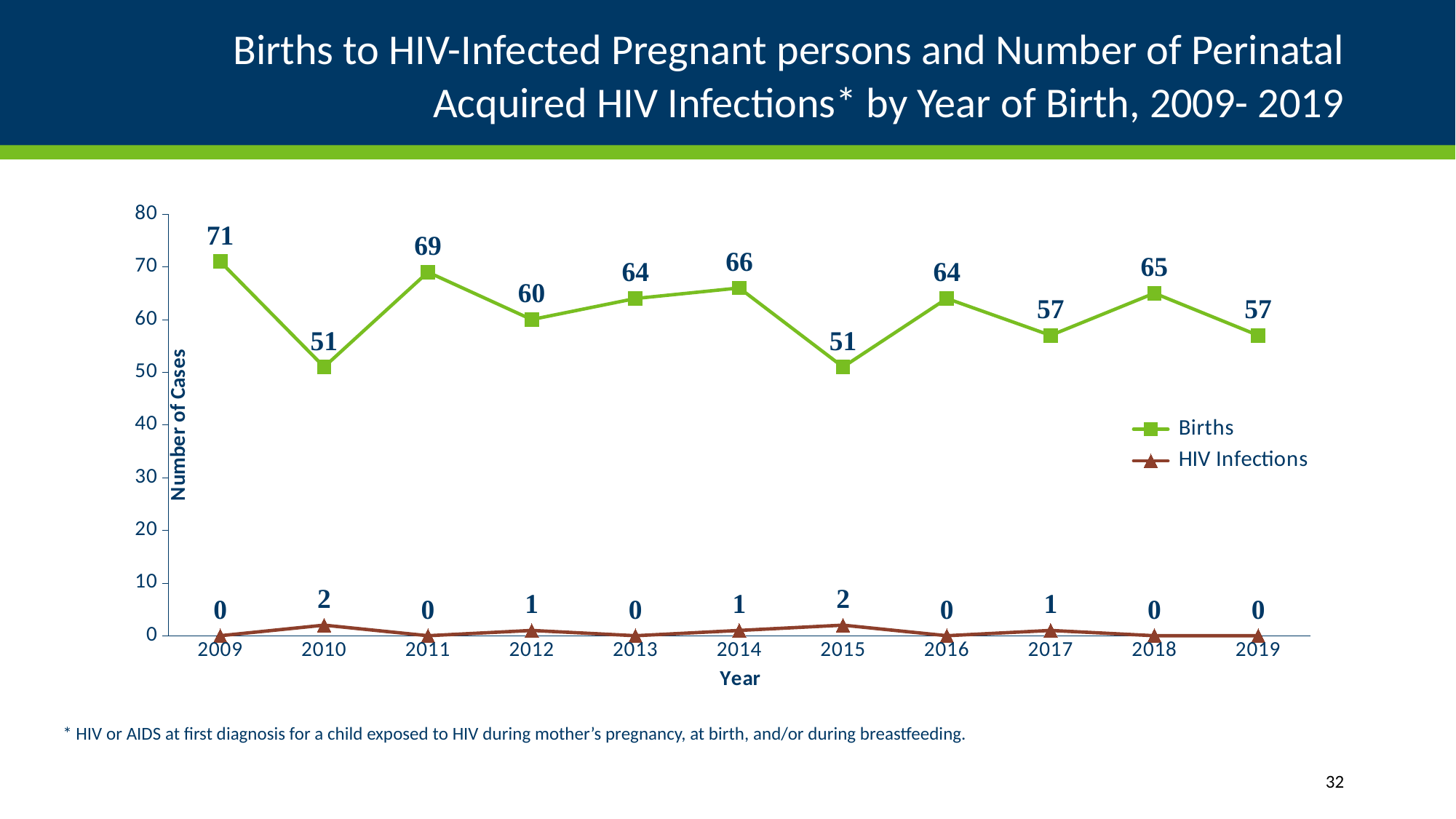
How many years are shown on the x axis? 11 What is the number of Births in 2019? 57 Which is larger, Births in 2011 or Births in 2014? Births in 2011 What is the lowest value plotted for the Births series? 51 How many series does the legend list? 2 What is the number of HIV Infections in 2015? 2 What is the number of Births in 2009? 71 Which year has the highest number of Births? 2009 What is the difference between Births in 2009 and Births in 2010? 20 What is the label of the y axis? Number of Cases What kind of chart is shown on the slide? Line chart Is the value for Births in 2016 greater or less than 60? greater